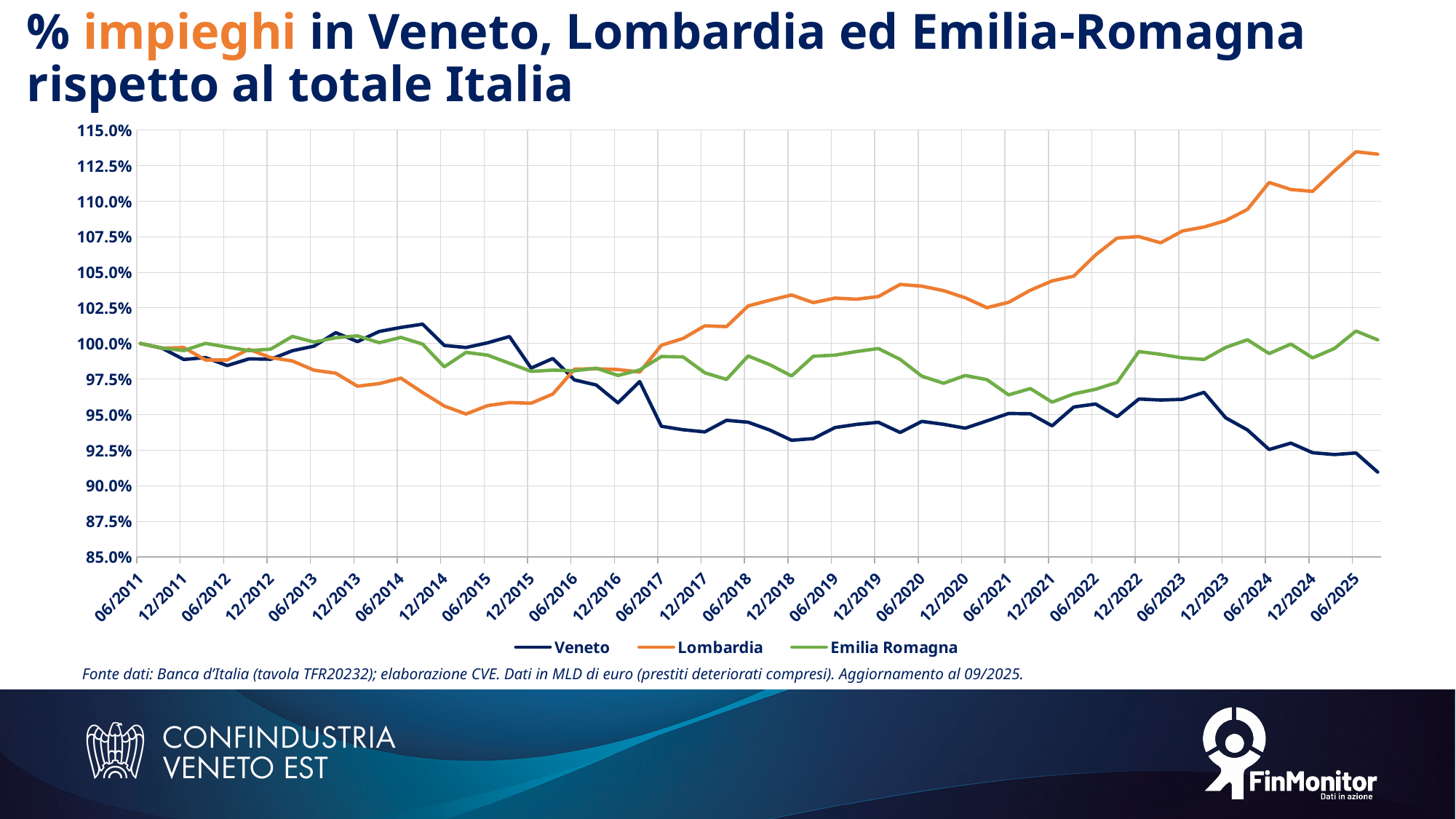
At 06/2015, which is larger: the value for Veneto or the value for Lombardia? Veneto Which series has the lowest value at 06/2025? Veneto Is the value for Emilia Romagna at 06/2021 greater or less than 97.5%? less Is the value for Lombardia at 06/2015 greater or less than 97.5%? less Is the value for Lombardia at 06/2025 greater or less than 110.0%? greater Which series is drawn in orange? Lombardia What is the value for Veneto at 06/2011? 100.0% Which series has the highest value at 06/2025? Lombardia How many series does the legend list? 3 Does the Lombardia line rise or fall overall from 06/2017 to 06/2025? rise What kind of chart is shown on the slide? line chart